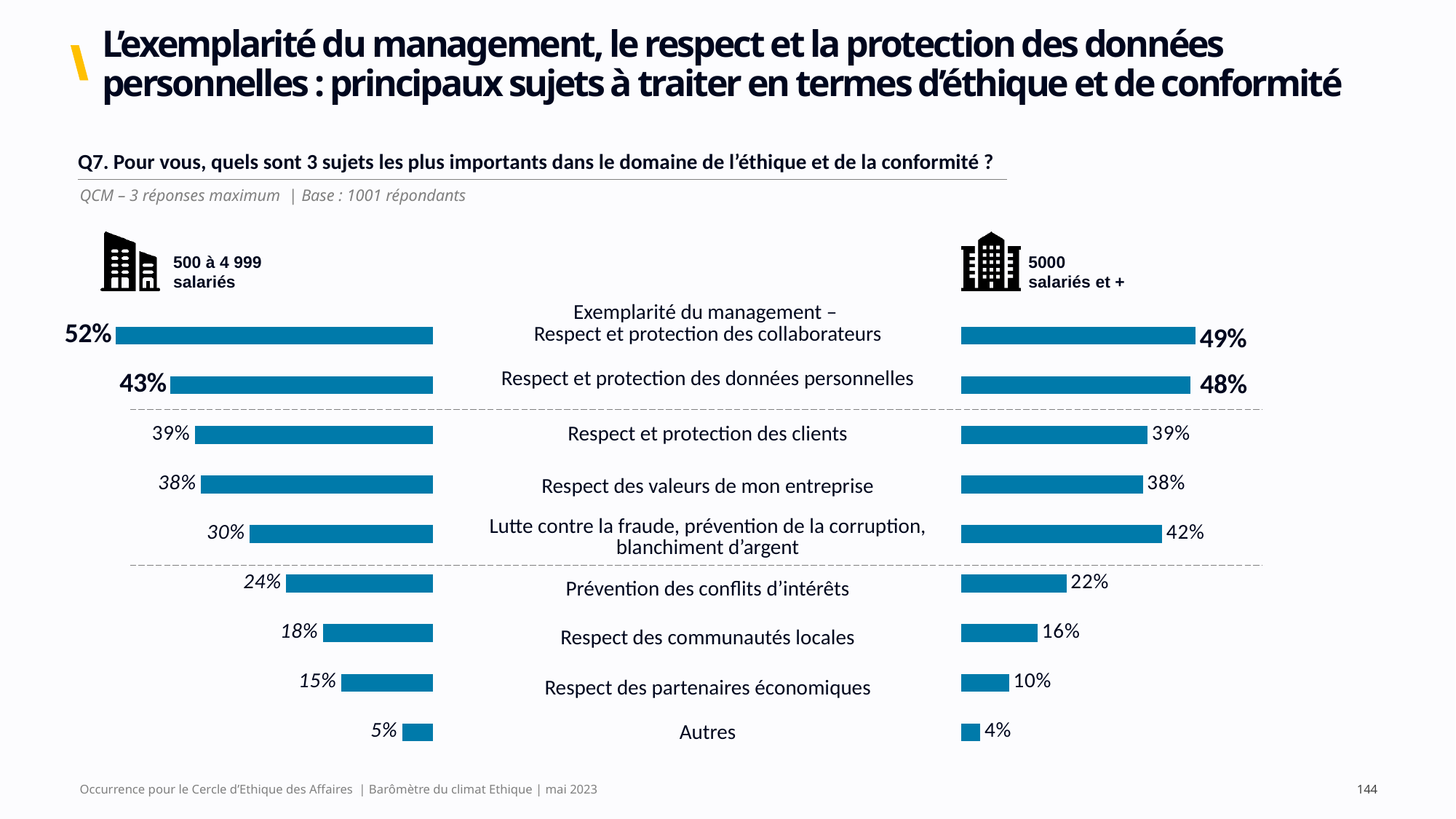
In the right chart (5000 salariés et +), what is the value for 'Lutte contre la fraude, prévention de la corruption, blanchiment d'argent'? 42% In the left chart (500 à 4 999 salariés), what is the value for 'Respect et protection des données personnelles'? 43% What is the difference between the left chart (500 à 4 999 salariés) and the right chart (5000 salariés et +) for 'Lutte contre la fraude, prévention de la corruption, blanchiment d'argent'? 12 percentage points What kind of chart is used on this slide? Bar chart What is the base (number of respondents) stated on the slide? 1001 répondants For 'Prévention des conflits d'intérêts', which chart shows the larger value: the left (500 à 4 999 salariés) or the right (5000 salariés et +)? Left (500 à 4 999 salariés) In the left chart (500 à 4 999 salariés), which category has the highest value? Exemplarité du management – Respect et protection des collaborateurs In the right chart (5000 salariés et +), which is larger: 'Respect et protection des clients' or 'Lutte contre la fraude, prévention de la corruption, blanchiment d'argent'? Lutte contre la fraude, prévention de la corruption, blanchiment d'argent In the left chart (500 à 4 999 salariés), what is the difference between 'Exemplarité du management – Respect et protection des collaborateurs' and 'Respect et protection des données personnelles'? 9 percentage points In the right chart (5000 salariés et +), what is the value for 'Respect des partenaires économiques'? 10% How many categories are shown in the left chart (500 à 4 999 salariés)? 9 In the right chart (5000 salariés et +), which category has the lowest value? Autres